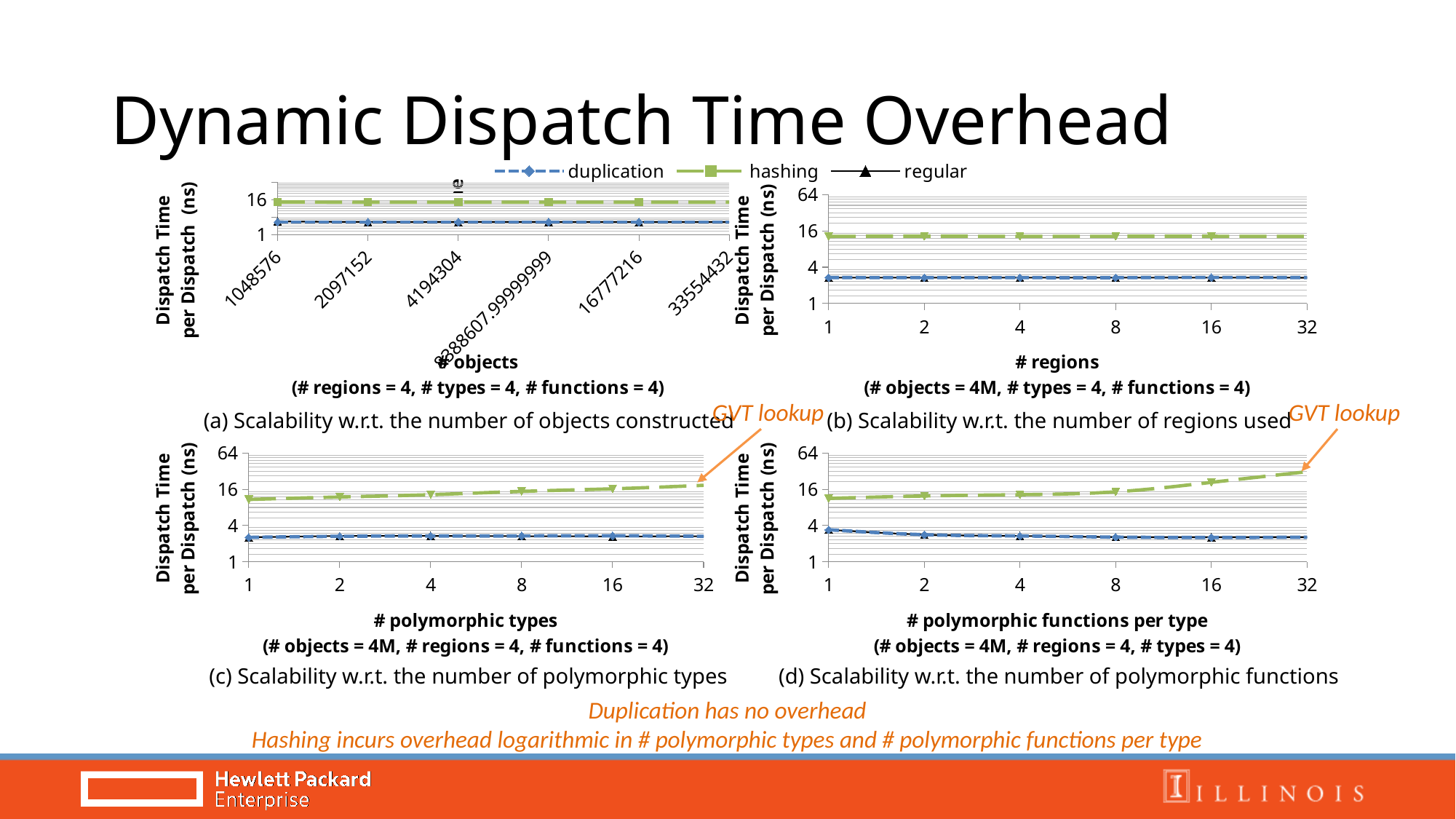
In chart (c), is the duplication value at 32 polymorphic types greater or less than 4? less In chart (d), is the hashing value at 32 polymorphic functions per type greater or less than 16? greater In chart (a), how many # objects values are shown on the x axis? 6 What is the x-axis title of chart (c)? # polymorphic types In chart (d), at 32 polymorphic functions per type, which series has the larger dispatch time: hashing or duplication? hashing In chart (b), is the hashing value at 1 region greater or less than 4? greater In chart (d), at which # polymorphic functions per type value is the hashing series highest? 32 How many series does the shared legend at the top of the slide list? 3 In chart (c), does the hashing series rise or fall as # polymorphic types increases? rise What kind of chart is chart (b), 'Scalability w.r.t. the number of regions used'? line chart In chart (d), does the hashing series rise or fall as # polymorphic functions per type increases? rise In chart (b), how many values of # regions are shown on the x axis? 6